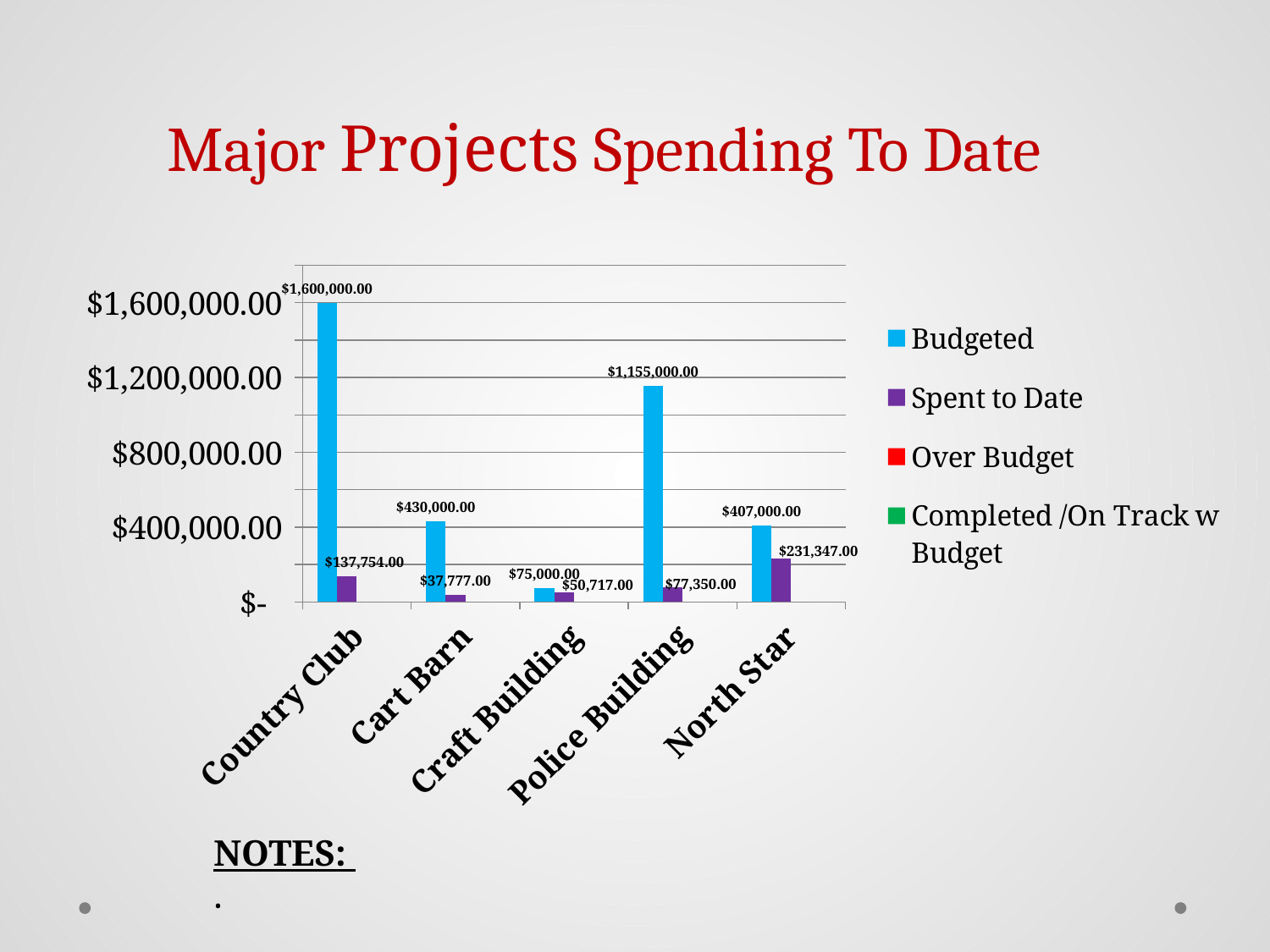
How many projects are shown on the x axis? 5 Which is larger, the Budgeted value for Cart Barn or the Budgeted value for North Star? Cart Barn What is the Spent to Date value for North Star? $231,347.00 Which project has the lowest Budgeted value? Craft Building What kind of chart is shown on the slide? Bar chart What is the difference between the Budgeted and Spent to Date values for Police Building? $1,077,650.00 What is the Budgeted value for Police Building? $1,155,000.00 How many series does the legend list? 4 Which project has the lowest Spent to Date value? Cart Barn What is the Spent to Date value for Craft Building? $50,717.00 What is the Budgeted value for Country Club? $1,600,000.00 Which project has the highest Budgeted value? Country Club